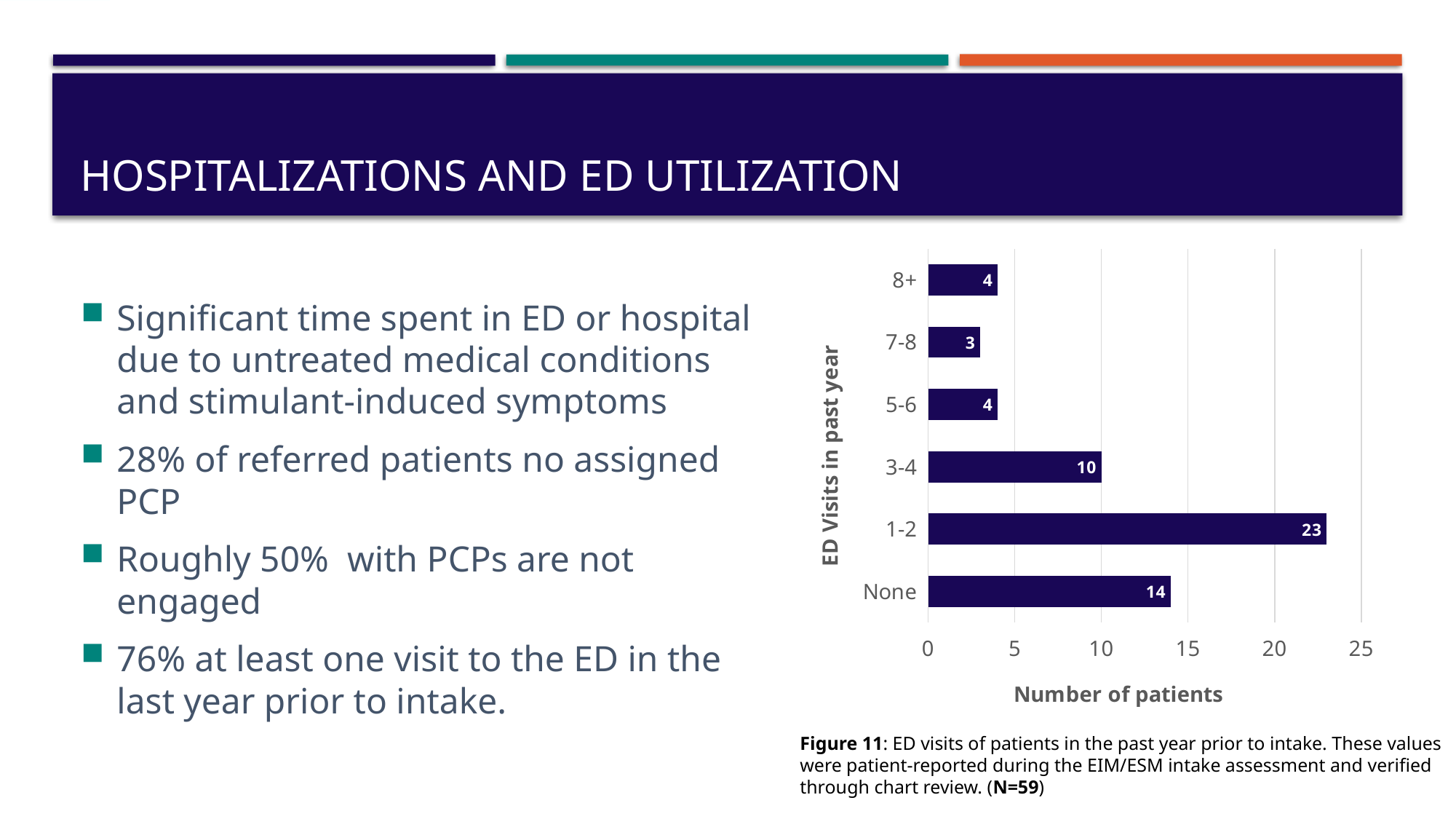
What kind of chart is shown on the slide? bar chart How many ED visit categories are shown on the chart? 6 How many patients had 3-4 ED visits in the past year? 10 Is the value for the 1-2 category greater or less than 20? greater How many patients had no ED visits (None) in the past year? 14 Which ED visit category has the highest number of patients? 1-2 What is the label of the horizontal axis of the chart? Number of patients How many patients had 7-8 ED visits in the past year? 3 How many patients had 1-2 ED visits in the past year? 23 Which ED visit category has the lowest number of patients? 7-8 Which category has more patients, 3-4 or 5-6? 3-4 What is the difference in number of patients between the 1-2 and None categories? 9